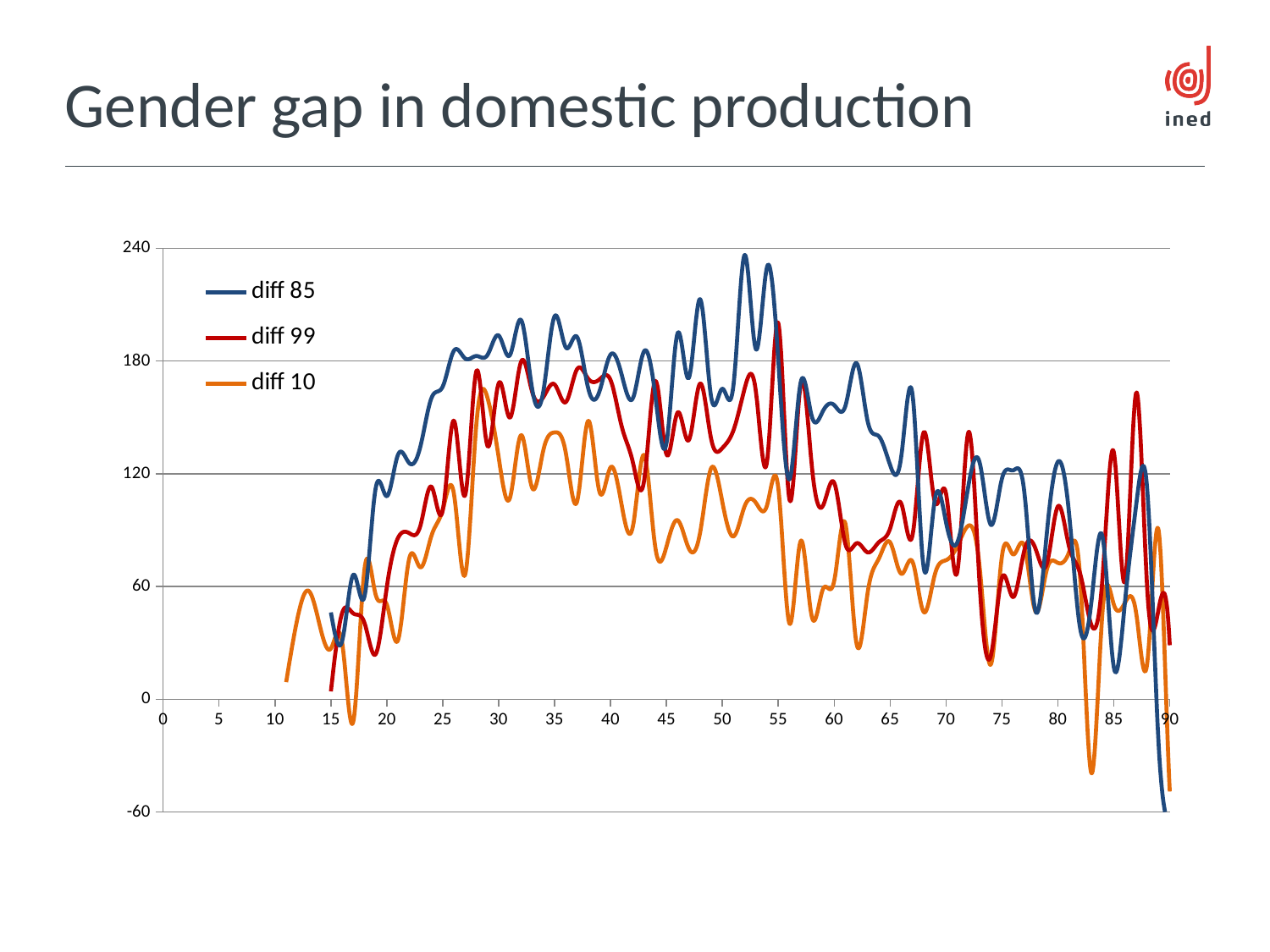
At age 35, which series has the larger value, diff 85 or diff 10? diff 85 Is the value of diff 10 at age 56 greater or less than 60? less What kind of chart is shown on the slide? line chart Which series reaches the highest value anywhere on the chart? diff 85 At age 52, which series has the larger value, diff 85 or diff 10? diff 85 Is the value of diff 85 at age 52 greater or less than 180? greater Is the value of diff 99 at age 15 greater or less than 60? less What are the three series named in the legend? diff 85, diff 99, diff 10 What is the title of the slide containing the chart? Gender gap in domestic production Does the diff 85 series generally rise or fall between ages 15 and 26? rise How many series does the legend list? 3